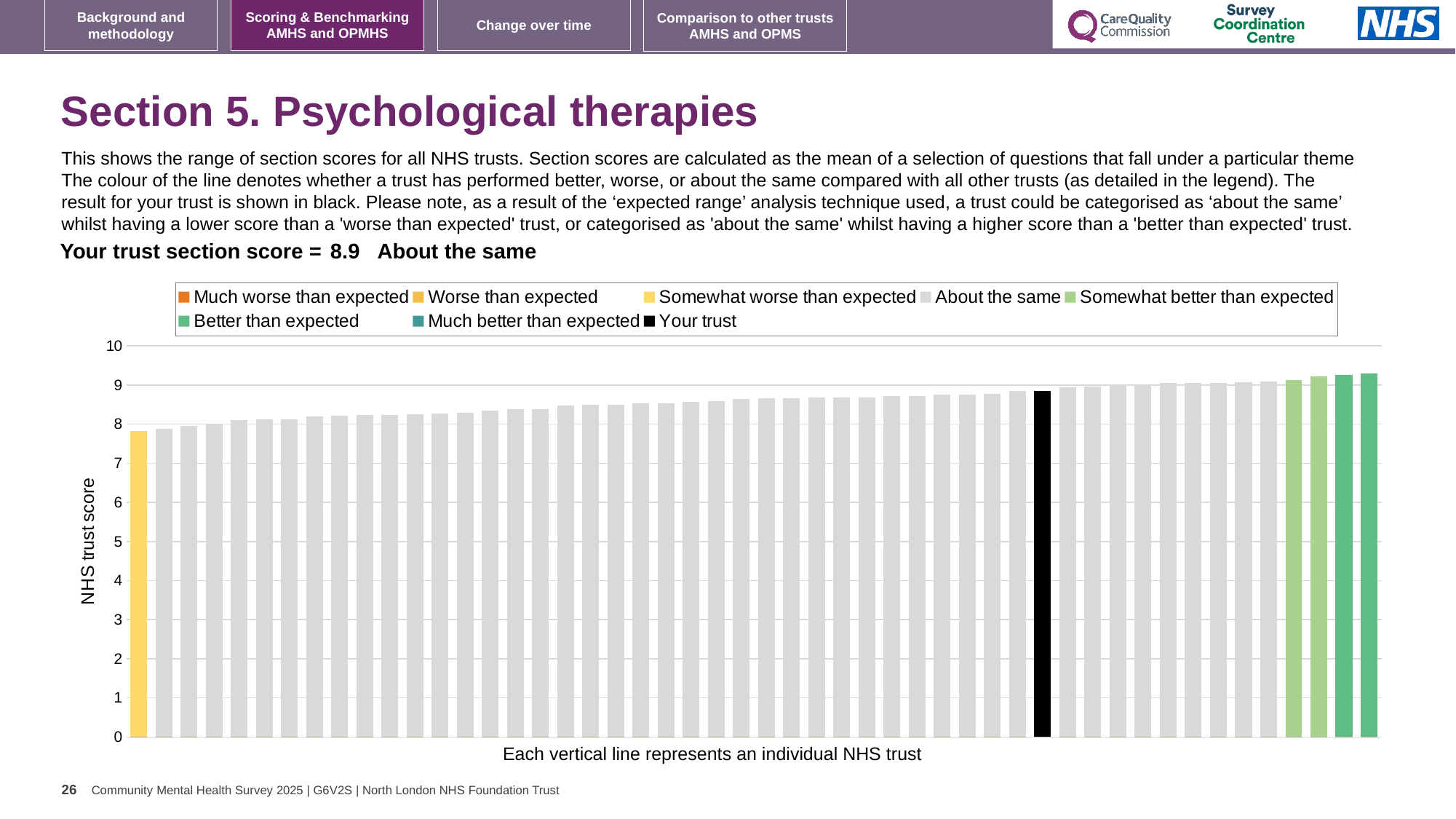
How many green bars are shown on the chart? 4 Is the value of the shortest bar on the chart greater or less than 7? greater What is the section score for your trust shown on the slide? 8.9 Is the value of the tallest bar on the chart greater or less than 9? greater What kind of chart is shown on the slide? Bar chart Is the value of the black 'Your trust' bar greater or less than 8? greater Which category is your trust placed in for this section? About the same What colour is the bar representing your trust? Black What is the label of the vertical axis? NHS trust score Do the bar values rise or fall from left to right along the x axis? rise How many entries does the chart legend list? 8